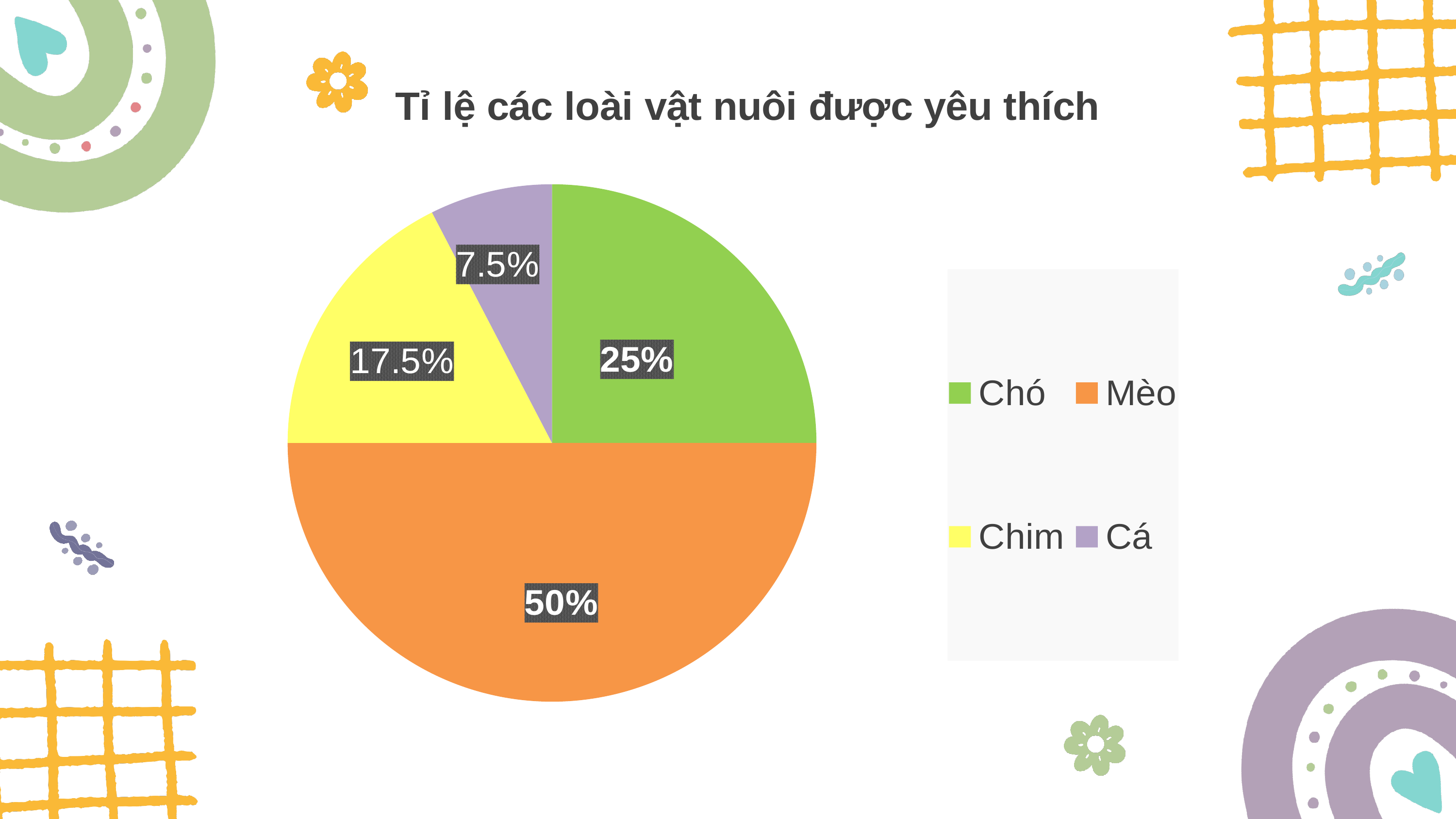
What is the title of the chart? Tỉ lệ các loài vật nuôi được yêu thích What percentage of the pie is Chó? 25% What is the difference between the shares of Mèo and Chó? 25% Which category has the largest slice of the pie? Mèo How many categories does the pie chart have? 4 Which is larger, the share for Chim or the share for Cá? Chim What kind of chart is shown on the slide? pie chart What colour is the slice for Chim? yellow What percentage of the pie is Chim? 17.5% Which category has the smallest slice of the pie? Cá What percentage of the pie is Cá? 7.5% What percentage of the pie is Mèo? 50%